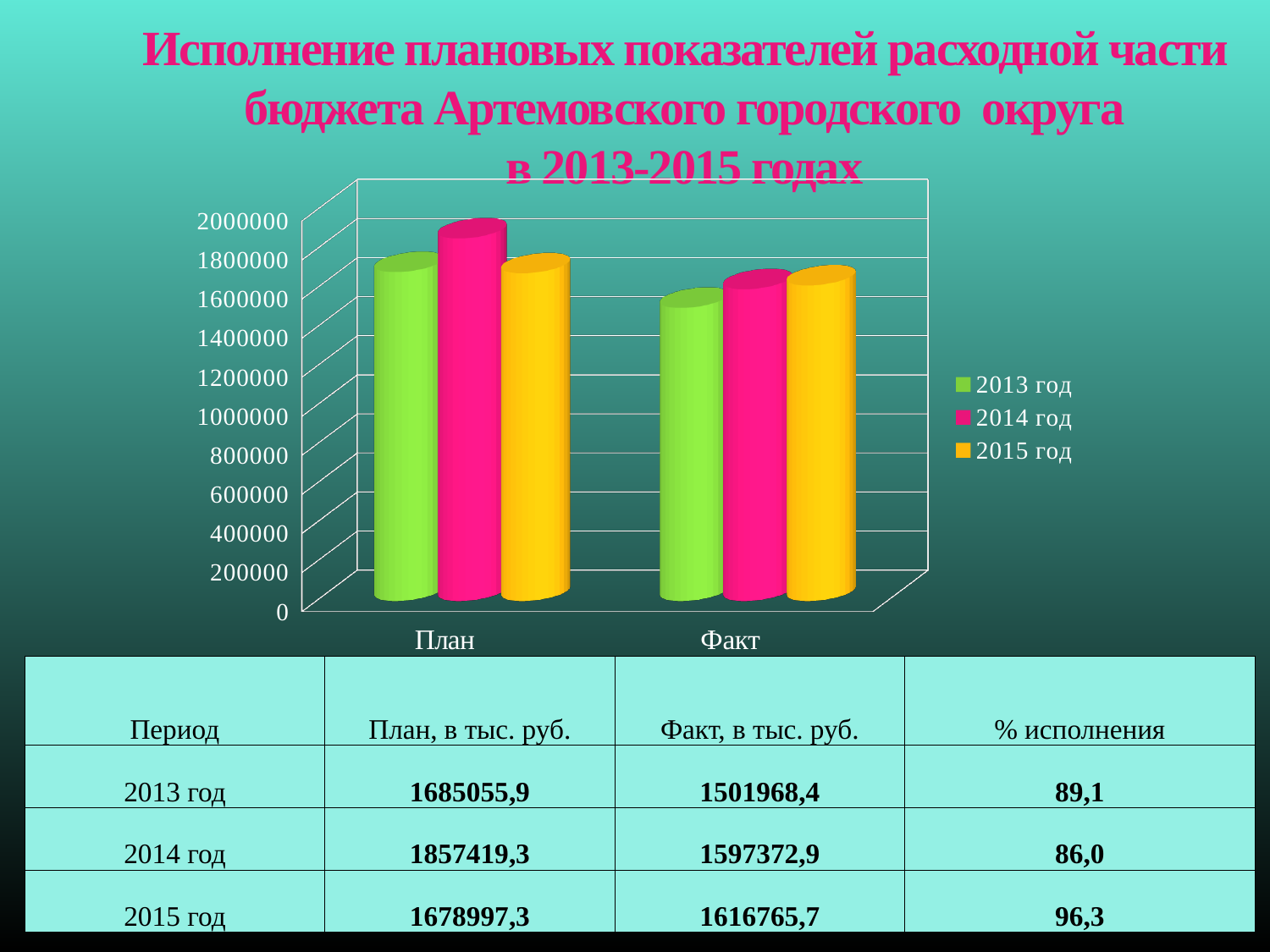
What is the План value for 2014 год, in thousand rubles? 1857419,3 How many series does the chart legend list? 3 Is the План value for 2014 год greater or less than 1800000? greater Which is larger for 2013 год: the План value or the Факт value? План Which year has the lowest value in the Факт category? 2013 год Which year has the highest value in the План category? 2014 год How many categories are shown on the x axis of the chart? 2 What is the Факт value for 2015 год, in thousand rubles? 1616765,7 Which series is shown in pink in the chart legend? 2014 год What is the difference between the План and Факт values for 2014 год, in thousand rubles? 260046,4 Is the Факт value for 2013 год greater or less than 1600000? less What kind of chart is shown on the slide? bar chart